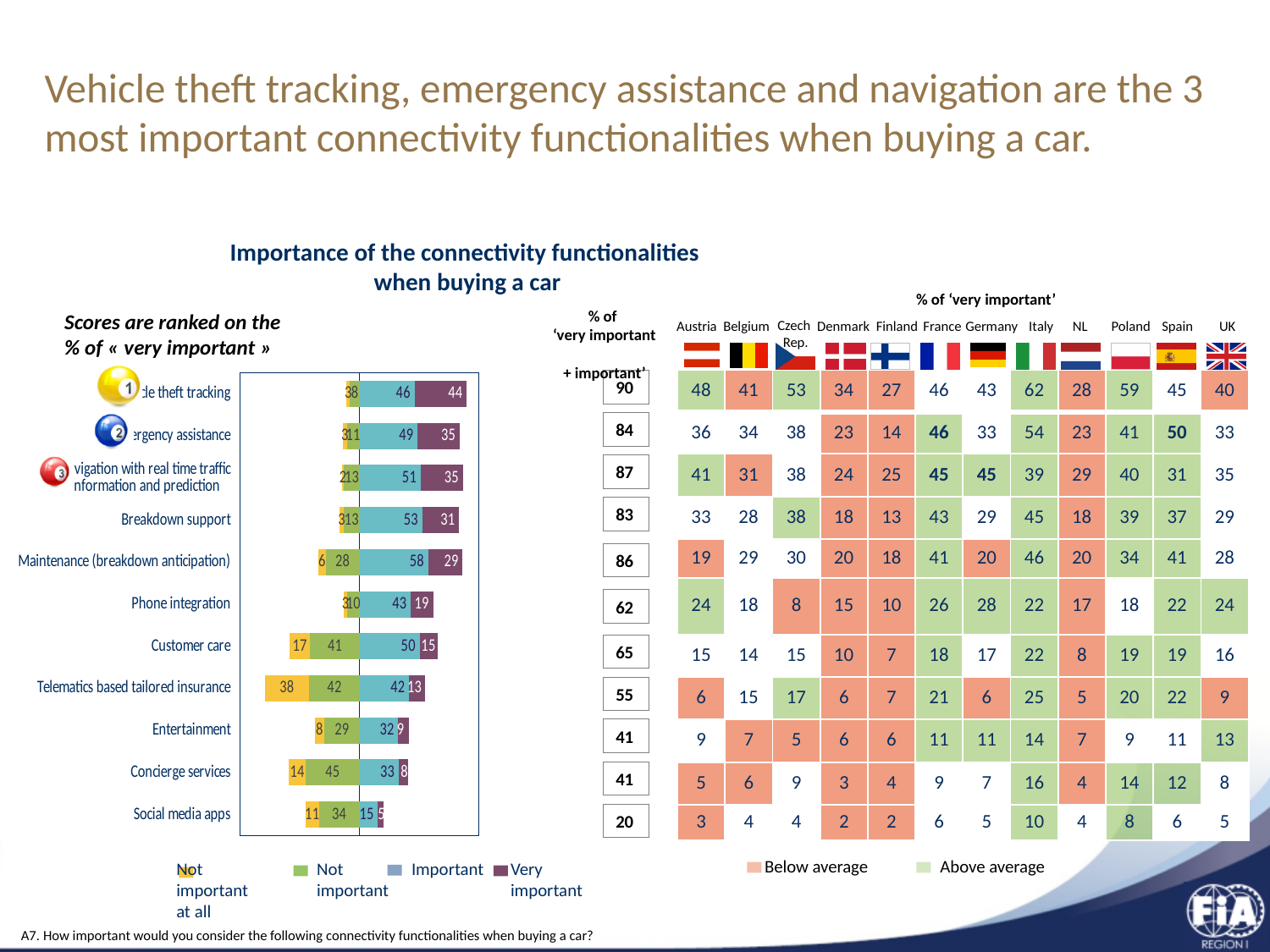
In the bar chart, what is the 'Not important at all' value for Telematics based tailored insurance? 38 How many series does the legend of the bar chart list? 4 How many connectivity functionalities are plotted in the bar chart? 11 Which functionality has the highest 'Important' value in the bar chart? Maintenance (breakdown anticipation) In the bar chart, what is the 'Important' value for Maintenance (breakdown anticipation)? 58 Which functionality has the highest 'Very important' value in the bar chart? Vehicle theft tracking In the bar chart, what is the 'Very important' value for Vehicle theft tracking? 44 What kind of chart is shown on the left of the slide? bar chart In the bar chart, which has the larger 'Important' value: Breakdown support or Emergency assistance? Breakdown support In the bar chart, what is the difference between the 'Very important' values for Vehicle theft tracking and Breakdown support? 13 In the bar chart, what is the 'Not important' value for Concierge services? 45 Which functionality has the lowest 'Very important' value in the bar chart? Social media apps